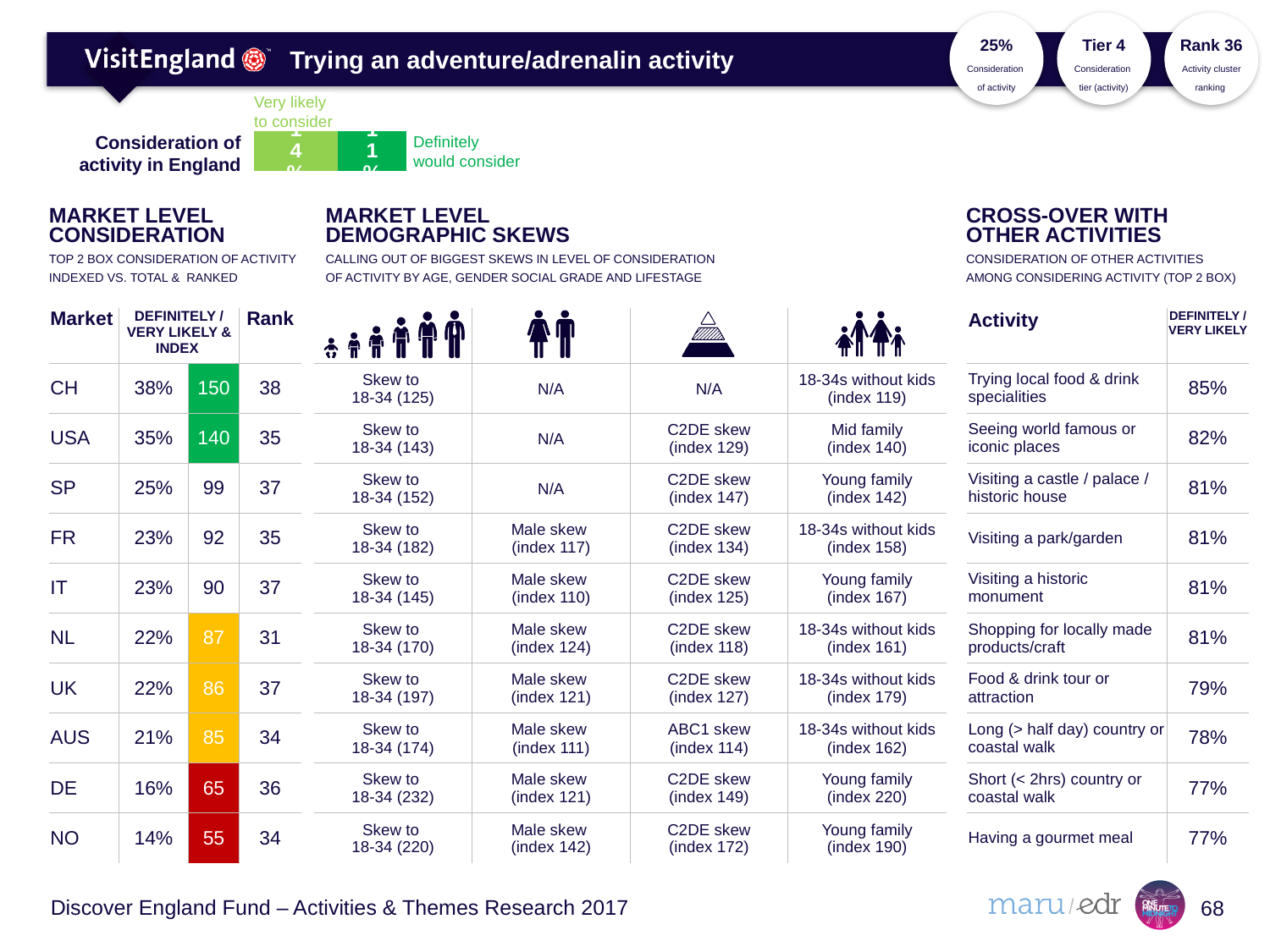
In the "Consideration of activity in England" bar chart, which segment is larger, "Very likely to consider" or "Definitely would consider"? Very likely to consider In the "Consideration of activity in England" bar chart, which segment is shown in the darker green? Definitely would consider In the "Consideration of activity in England" bar chart, which segment is the smallest? Definitely would consider In the "Consideration of activity in England" bar chart, what is the value for "Definitely would consider"? 11% What kind of chart is shown next to "Consideration of activity in England"? bar chart In the "Consideration of activity in England" bar chart, what is the difference between the "Very likely to consider" and "Definitely would consider" values? 3% In the "Consideration of activity in England" bar chart, what is the value for "Very likely to consider"? 14% In the "Consideration of activity in England" bar chart, what is the total of the stacked bar? 25% How many segments make up the "Consideration of activity in England" stacked bar? 2